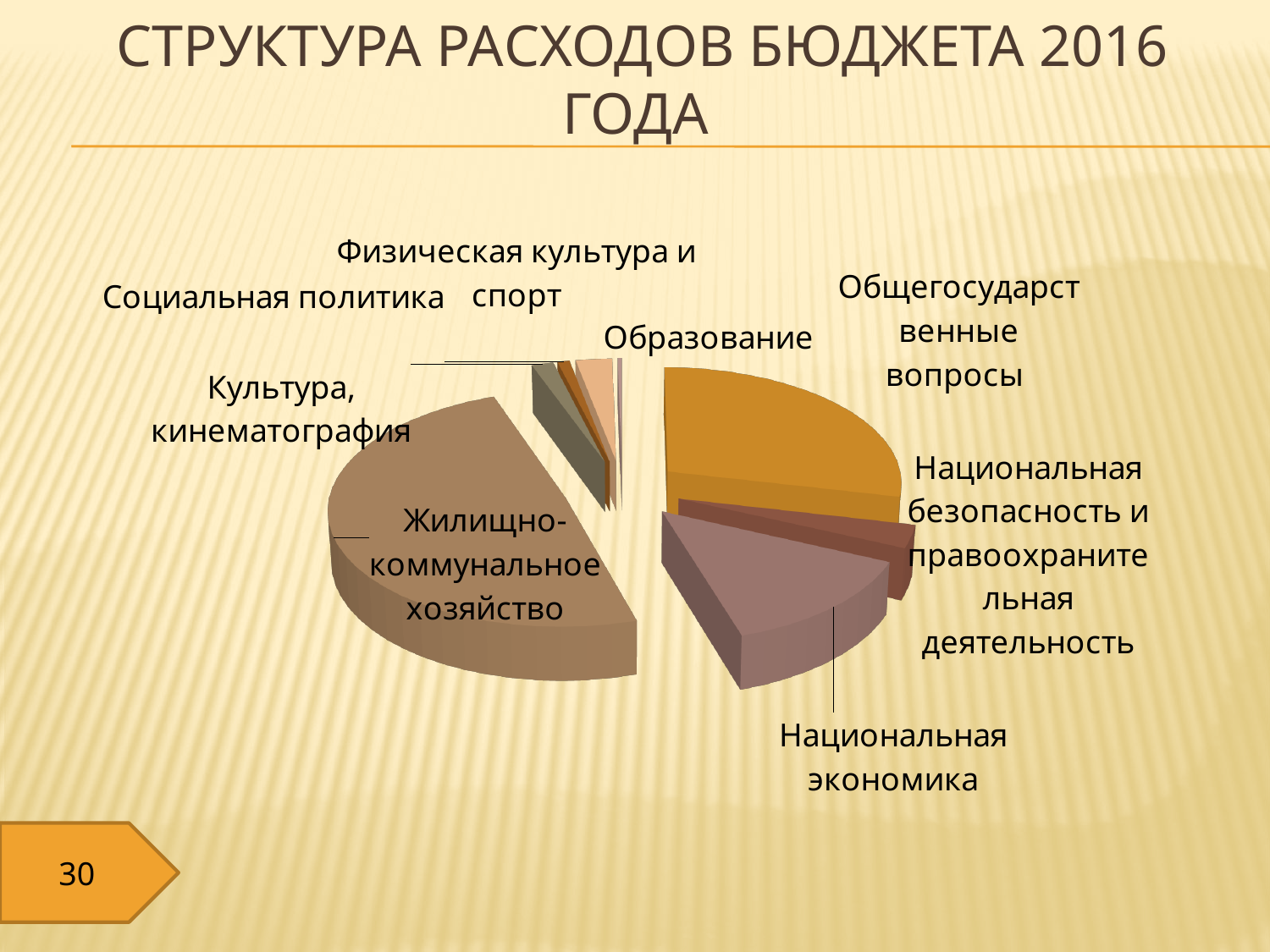
Which slice is larger: Национальная экономика or Образование? Национальная экономика Which year's budget expenditure structure does the chart show? 2016 Which category has the largest slice of the pie? Жилищно-коммунальное хозяйство What is the title of the chart on the slide? СТРУКТУРА РАСХОДОВ БЮДЖЕТА 2016 ГОДА Which slice is larger: Жилищно-коммунальное хозяйство or Национальная экономика? Жилищно-коммунальное хозяйство Which slice is larger: Общегосударственные вопросы or Социальная политика? Общегосударственные вопросы What kind of chart is shown on the slide? Pie chart How many categories (slices) does the pie chart show? 8